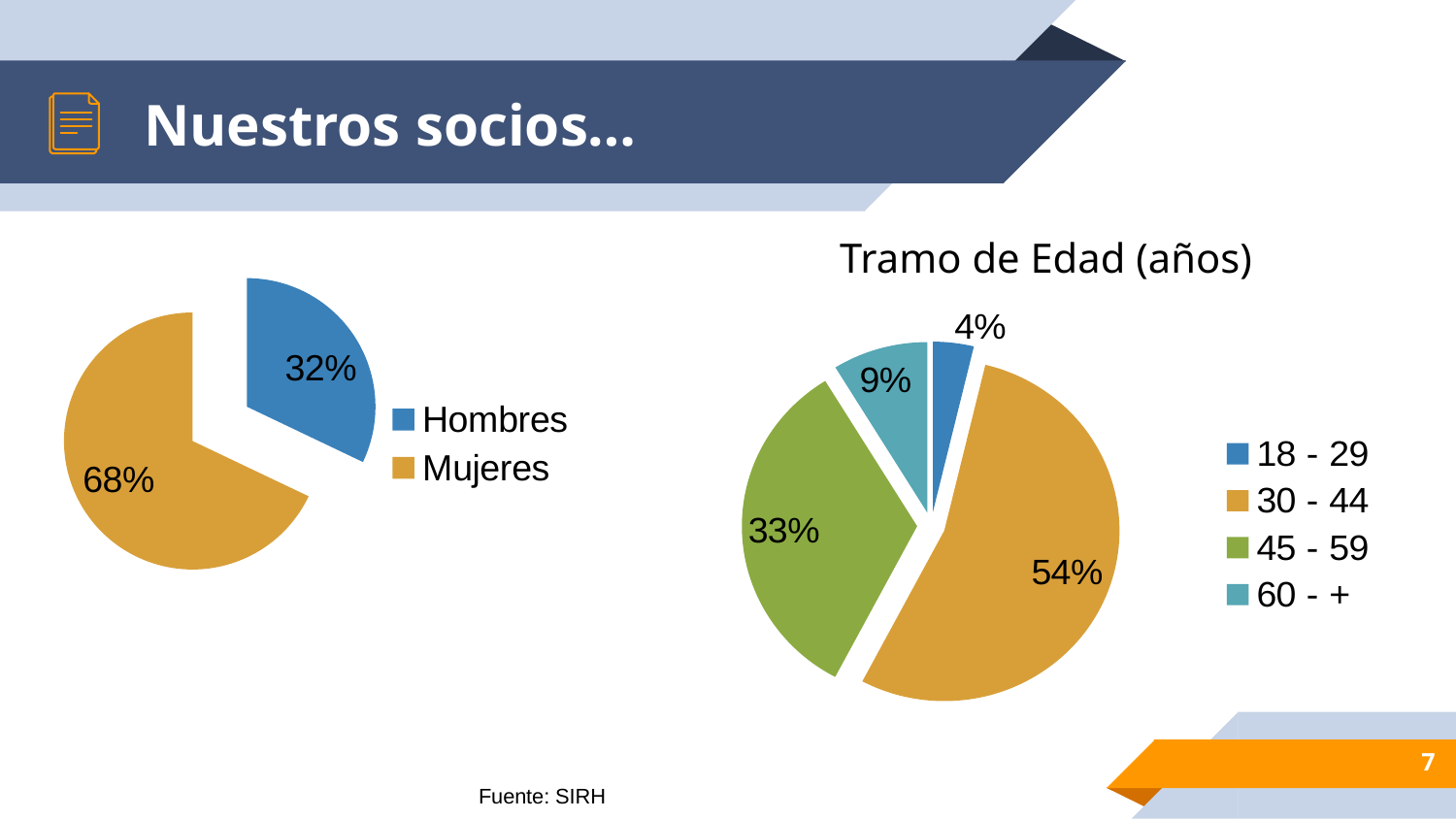
In the left pie chart (Hombres/Mujeres), what is the difference in percentage points between Mujeres and Hombres? 36 In the chart titled 'Tramo de Edad (años)', how many age groups are shown? 4 In the chart titled 'Tramo de Edad (años)', what share is labelled for the 45 - 59 group? 33% In the left pie chart (Hombres/Mujeres), what share is labelled for Hombres? 32% In the left pie chart (Hombres/Mujeres), what share is labelled for Mujeres? 68% In the chart titled 'Tramo de Edad (años)', what share is labelled for the 30 - 44 group? 54% In the chart titled 'Tramo de Edad (años)', which age group has the largest share? 30 - 44 In the chart titled 'Tramo de Edad (años)', which age group has the smallest share? 18 - 29 In the left pie chart (Hombres/Mujeres), which category has the larger share? Mujeres In the left pie chart (Hombres/Mujeres), how many categories does the legend list? 2 What type of chart is the chart titled 'Tramo de Edad (años)'? Pie chart In the chart titled 'Tramo de Edad (años)', what share is labelled for the 60 - + group? 9%